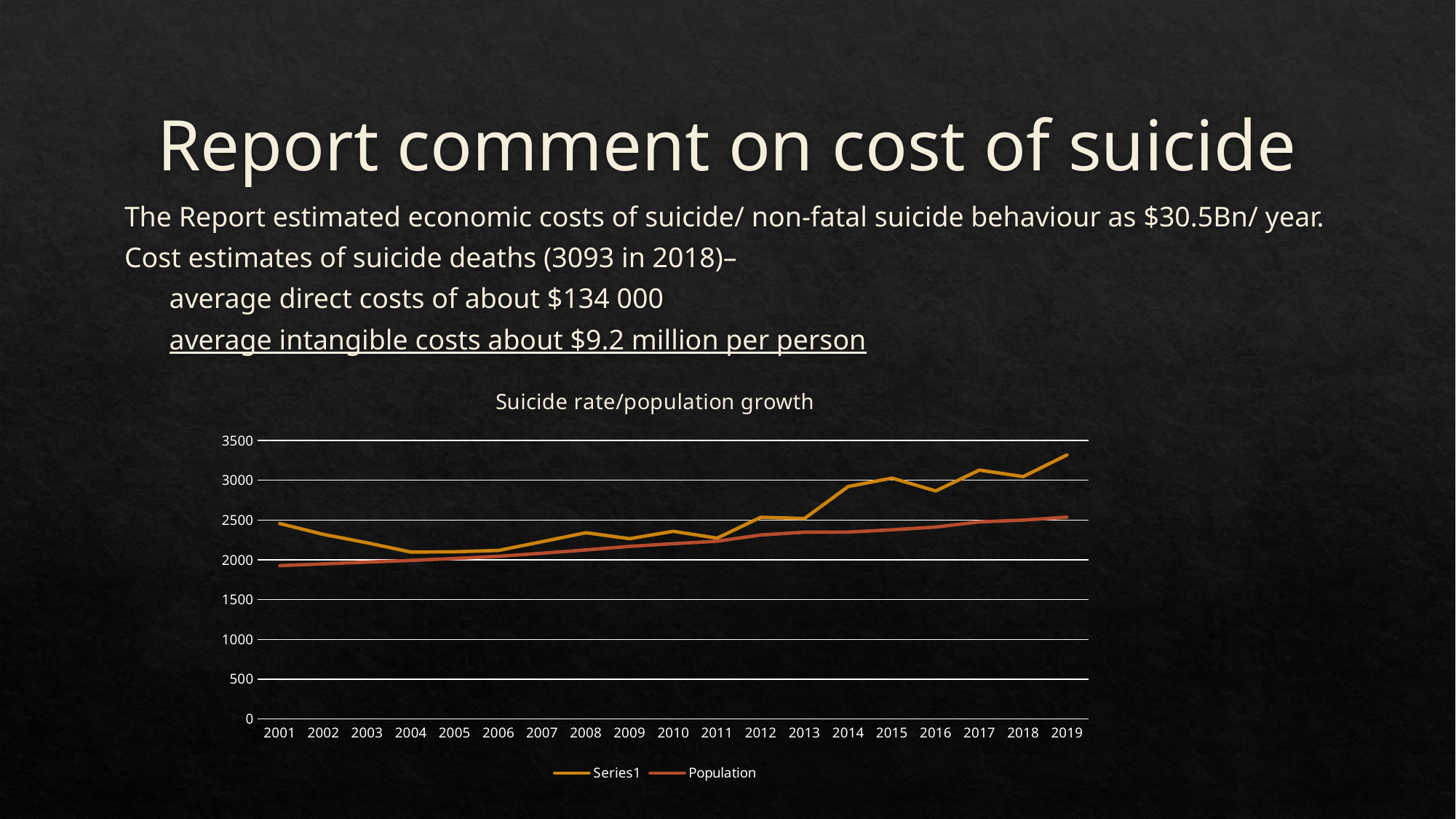
Does the Population line rise or fall from 2001 to 2019? rise In which year does Series1 reach its highest value? 2019 In which year is the Population line at its lowest? 2001 How many series does the chart legend list? 2 In 2019, which series has the larger value, Series1 or Population? Series1 Is the value of Population in 2001 greater or less than 2000? less Is the value of Series1 in 2014 greater or less than 2500? greater What kind of chart is shown on the slide? line chart What is the title of the chart? Suicide rate/population growth Is the value of Series1 in 2019 greater or less than 3000? greater How many years are shown along the x axis of the chart? 19 What are the names of the two series in the legend? Series1 and Population